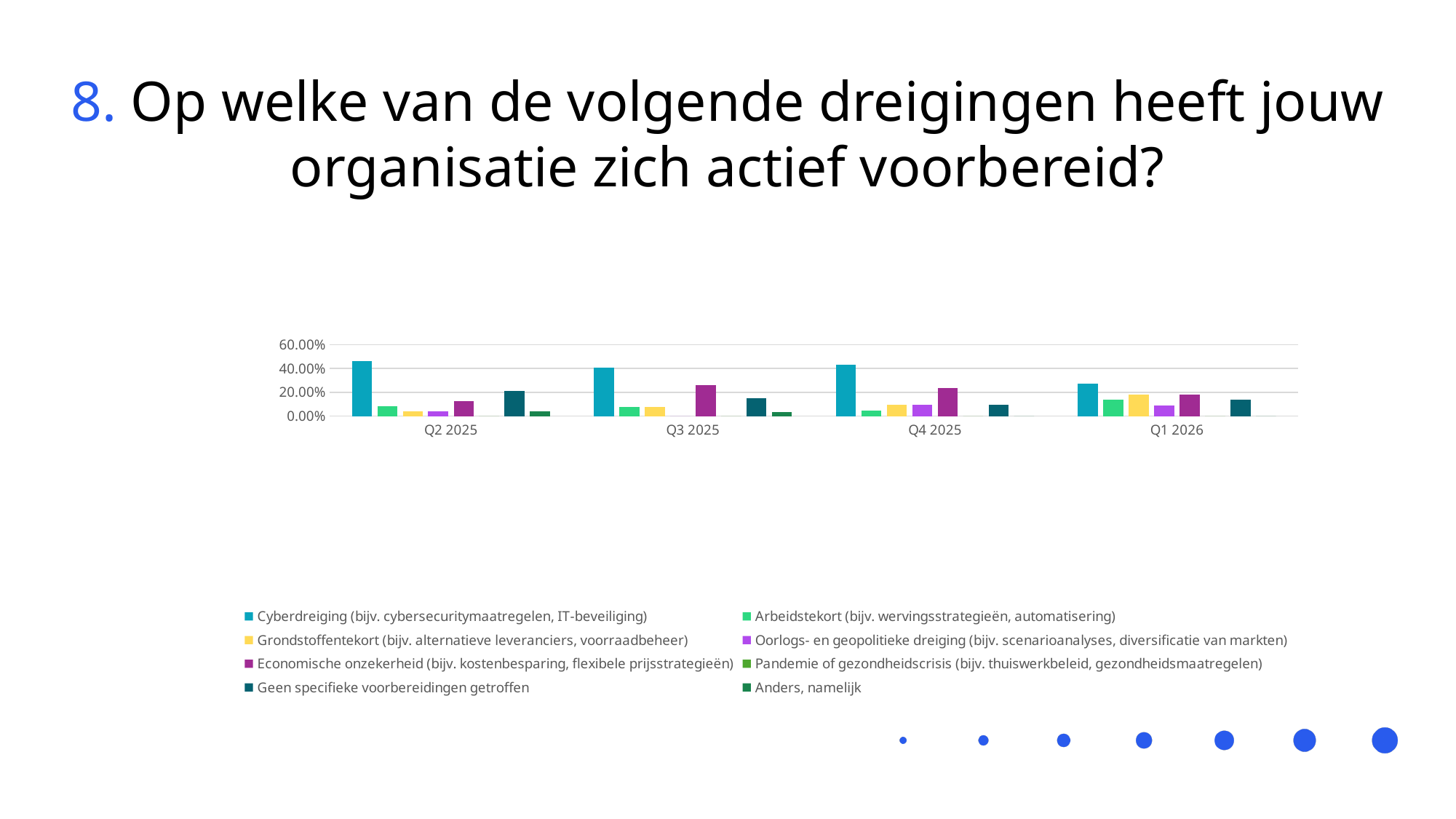
Is the value for Cyberdreiging in Q1 2026 higher or lower than in Q2 2025? lower Is the value for Cyberdreiging in Q1 2026 greater or less than 40.00%? less In Q1 2026, which is larger: Economische onzekerheid or Oorlogs- en geopolitieke dreiging? Economische onzekerheid What kind of chart is shown on the slide? bar chart Is the value for Cyberdreiging in Q2 2025 greater or less than 40.00%? greater Which category label appears last (rightmost) on the x axis? Q1 2026 Is the value for Economische onzekerheid in Q3 2025 greater or less than 20.00%? greater Which series has the highest value in Q1 2026? Cyberdreiging (bijv. cybersecuritymaatregelen, IT-beveiliging) Which series has the highest value in Q2 2025? Cyberdreiging (bijv. cybersecuritymaatregelen, IT-beveiliging) How many series does the chart's legend list? 8 How many quarters (categories) are shown on the x axis of the chart? 4